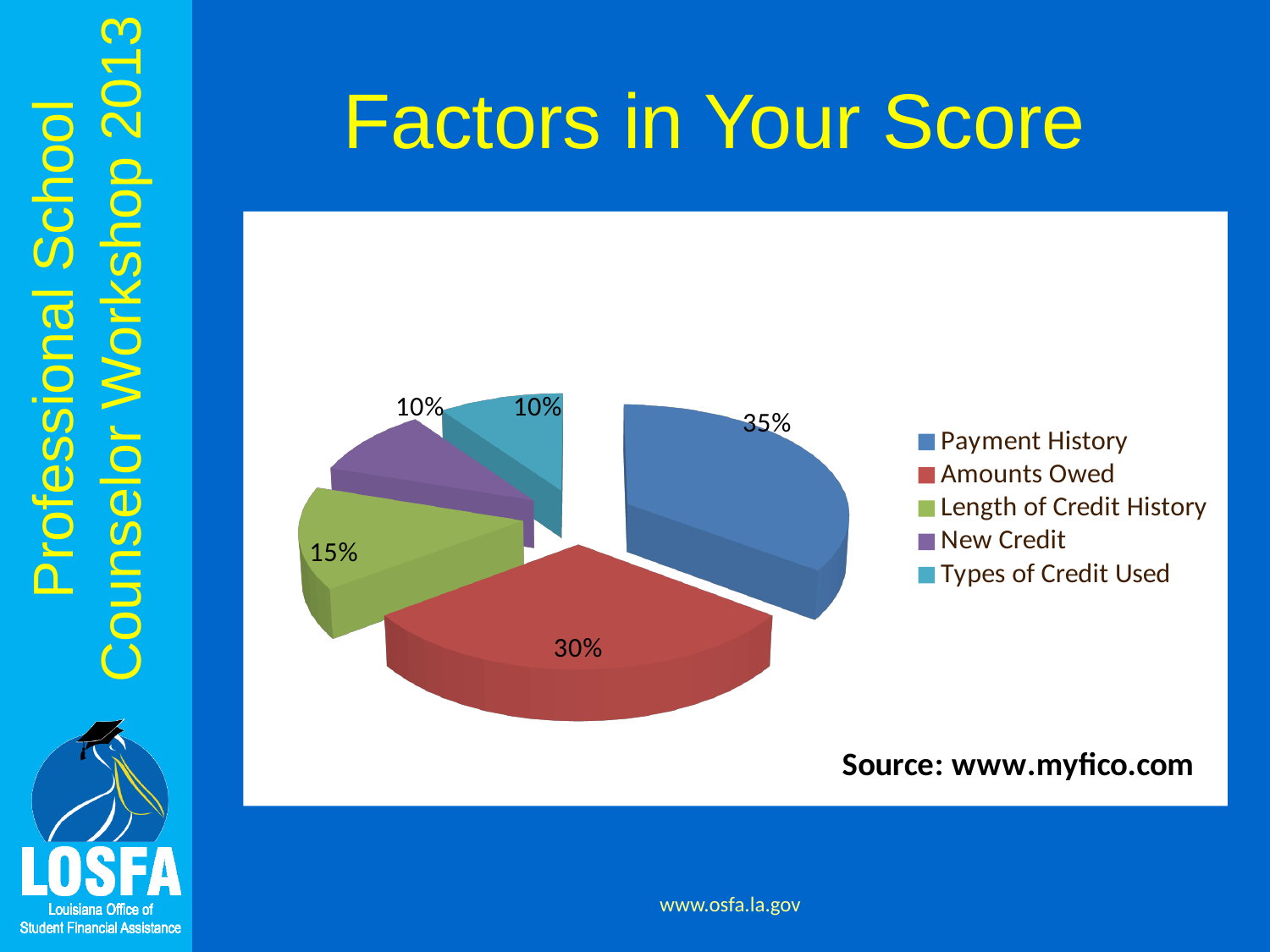
What is the difference in percentage points between Payment History and Amounts Owed? 5% What share of the pie does Length of Credit History represent? 15% What is the difference in percentage points between Amounts Owed and Length of Credit History? 15% How many slices does the pie chart have? 5 What share of the pie does Amounts Owed represent? 30% How many entries does the legend list? 5 What kind of chart is shown on the slide? pie chart What share of the pie does Payment History represent? 35% Which factor has the smallest share of the pie, Length of Credit History or Amounts Owed? Length of Credit History What share of the pie does New Credit represent? 10% Which factor has the largest share of the pie? Payment History What is the title of the slide containing the chart? Factors in Your Score